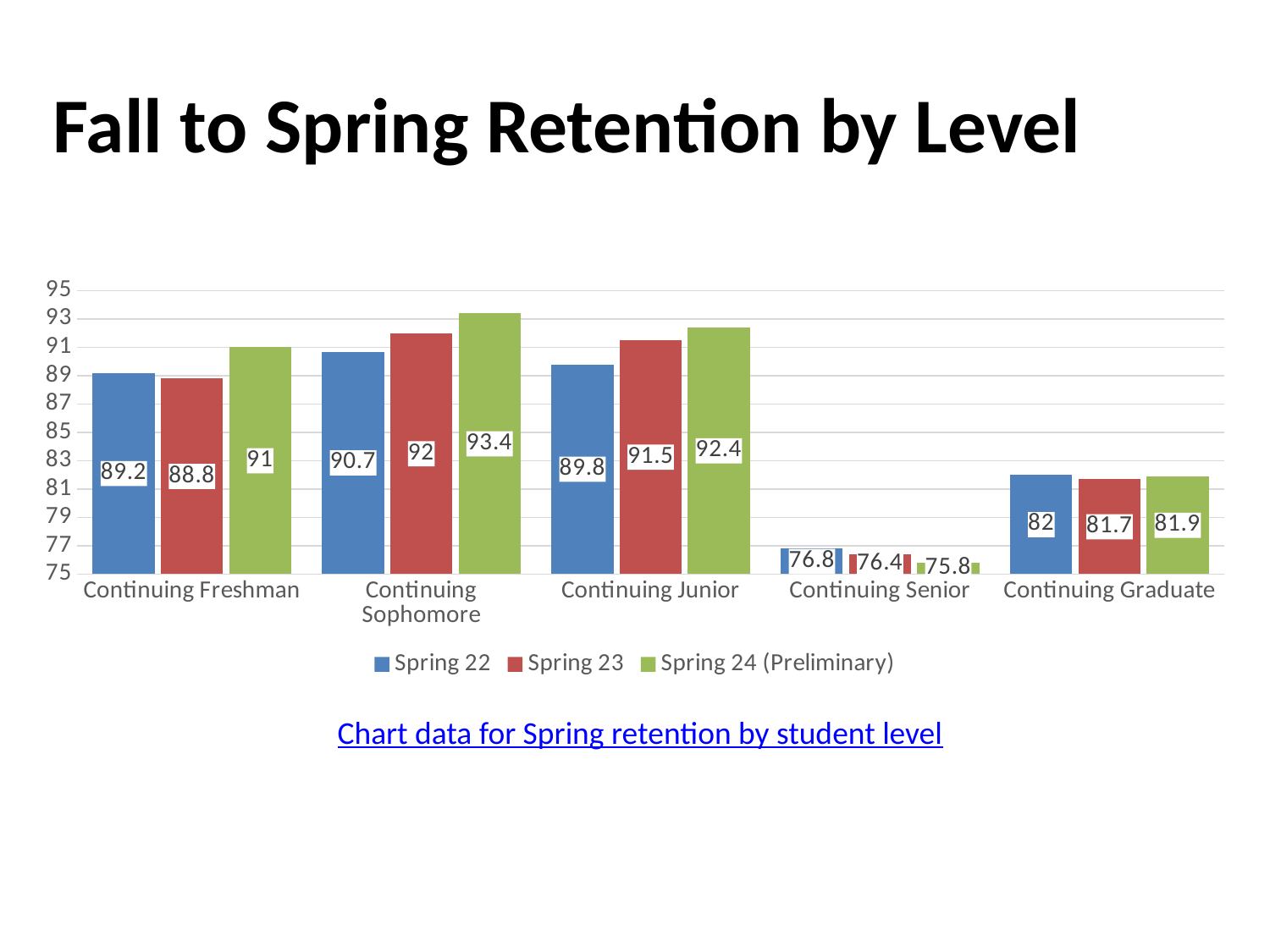
Which is larger for Continuing Freshman: the Spring 22 value or the Spring 23 value? Spring 22 What is the Spring 24 (Preliminary) retention value for Continuing Sophomore? 93.4 How many student level categories are shown on the x axis? 5 What is the title of the chart on the slide? Fall to Spring Retention by Level Is the Spring 22 value for Continuing Graduate greater or less than 85? less Which student level has the highest Spring 24 (Preliminary) retention value? Continuing Sophomore Which student level has the lowest Spring 23 retention value? Continuing Senior What kind of chart is shown on the slide? bar chart What is the Spring 23 retention value for Continuing Graduate? 81.7 How many series does the legend list? 3 What is the Spring 22 retention value for Continuing Senior? 76.8 What is the difference between the Spring 24 (Preliminary) and Spring 22 values for Continuing Junior? 2.6